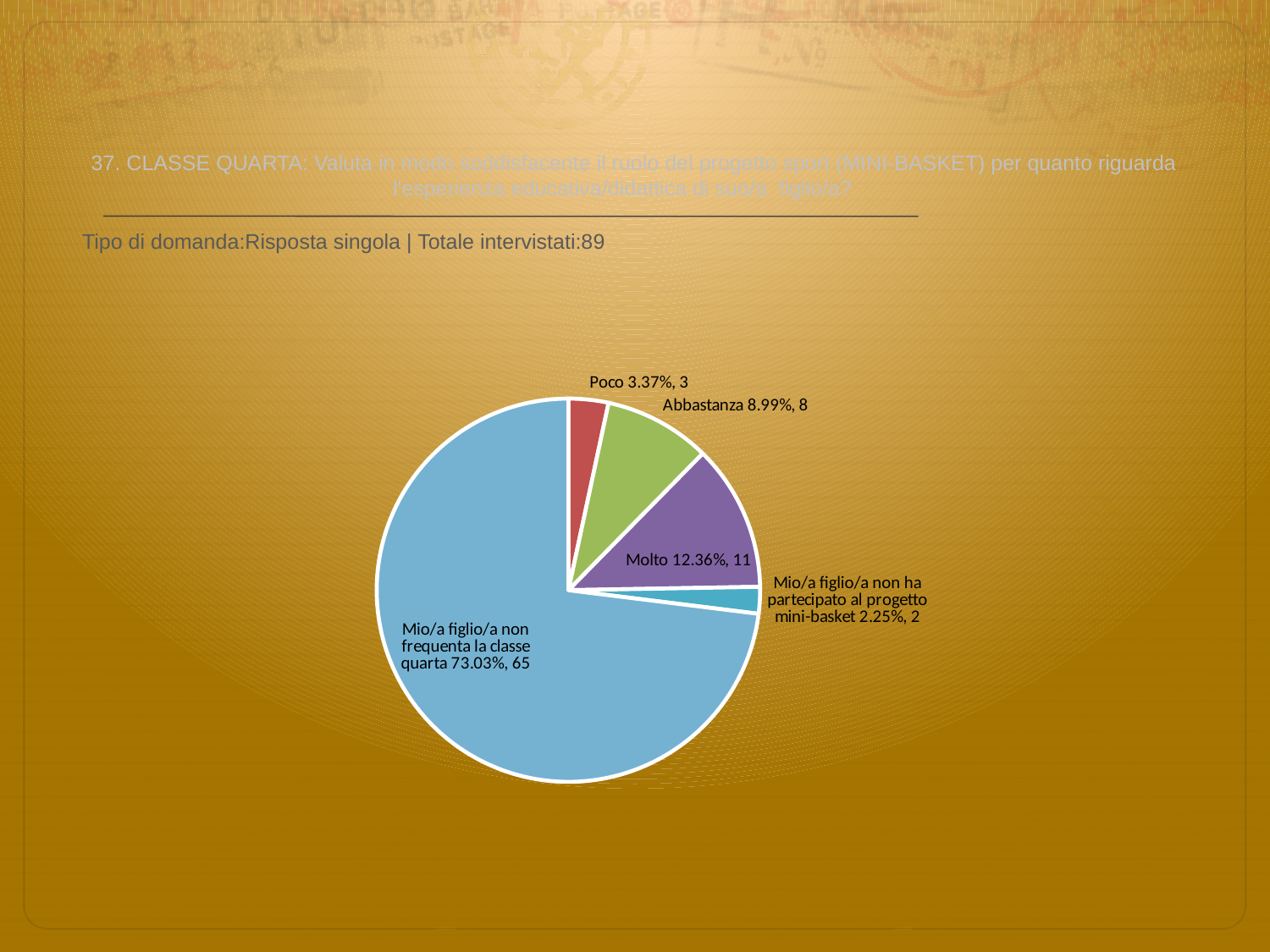
How many respondents answered 'Abbastanza'? 8 What kind of chart is shown on the slide? pie chart Which category has the smallest slice of the pie? Mio/a figlio/a non ha partecipato al progetto mini-basket How many slices does the pie chart have? 5 What colour is the 'Molto' slice? purple What is the difference in count between 'Molto' and 'Abbastanza'? 3 Which has more respondents, 'Poco' or 'Mio/a figlio/a non ha partecipato al progetto mini-basket'? Poco What is the total number of respondents shown on the slide? 89 What percentage share does the 'Mio/a figlio/a non frequenta la classe quarta' slice have? 73.03% How many respondents answered 'Poco'? 3 Which category has the largest slice of the pie? Mio/a figlio/a non frequenta la classe quarta What percentage share does the 'Molto' slice have? 12.36%